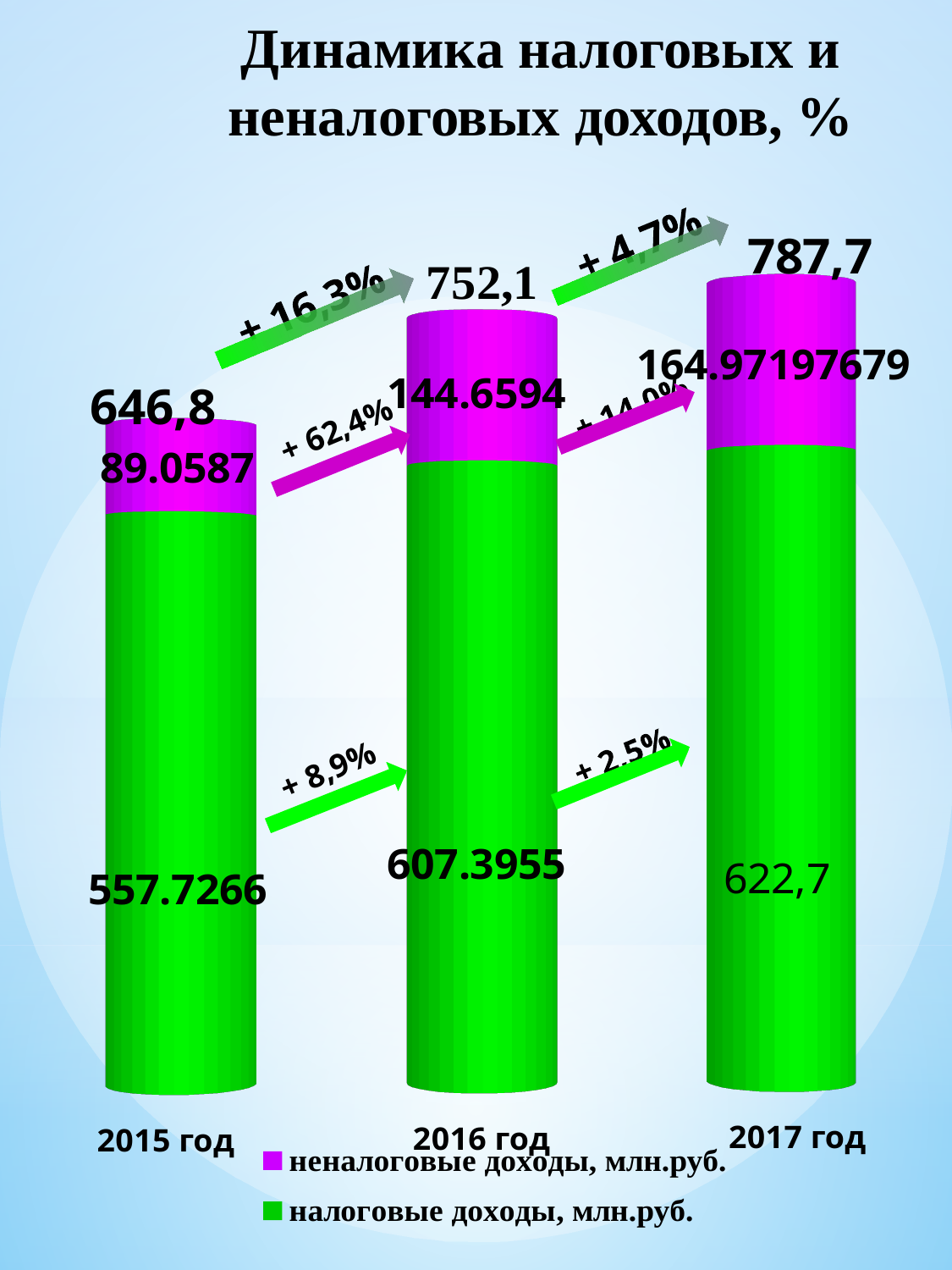
What is the value of неналоговые доходы for 2015 год? 89.0587 Which year has the highest value for налоговые доходы? 2017 год Which is larger: неналоговые доходы in 2016 год or in 2015 год? 2016 год What is the total shown above the stacked bar for 2015 год? 646,8 What is the total shown above the stacked bar for 2016 год? 752,1 Which year has the lowest value for неналоговые доходы? 2015 год Do the stacked bar totals rise or fall from 2015 год to 2017 год? rise How many years (categories) are shown on the x axis? 3 What is the value of налоговые доходы for 2016 год? 607.3955 How many series does the legend list? 2 What is the value of налоговые доходы for 2017 год? 622,7 What is the value of неналоговые доходы for 2017 год? 164.97197679